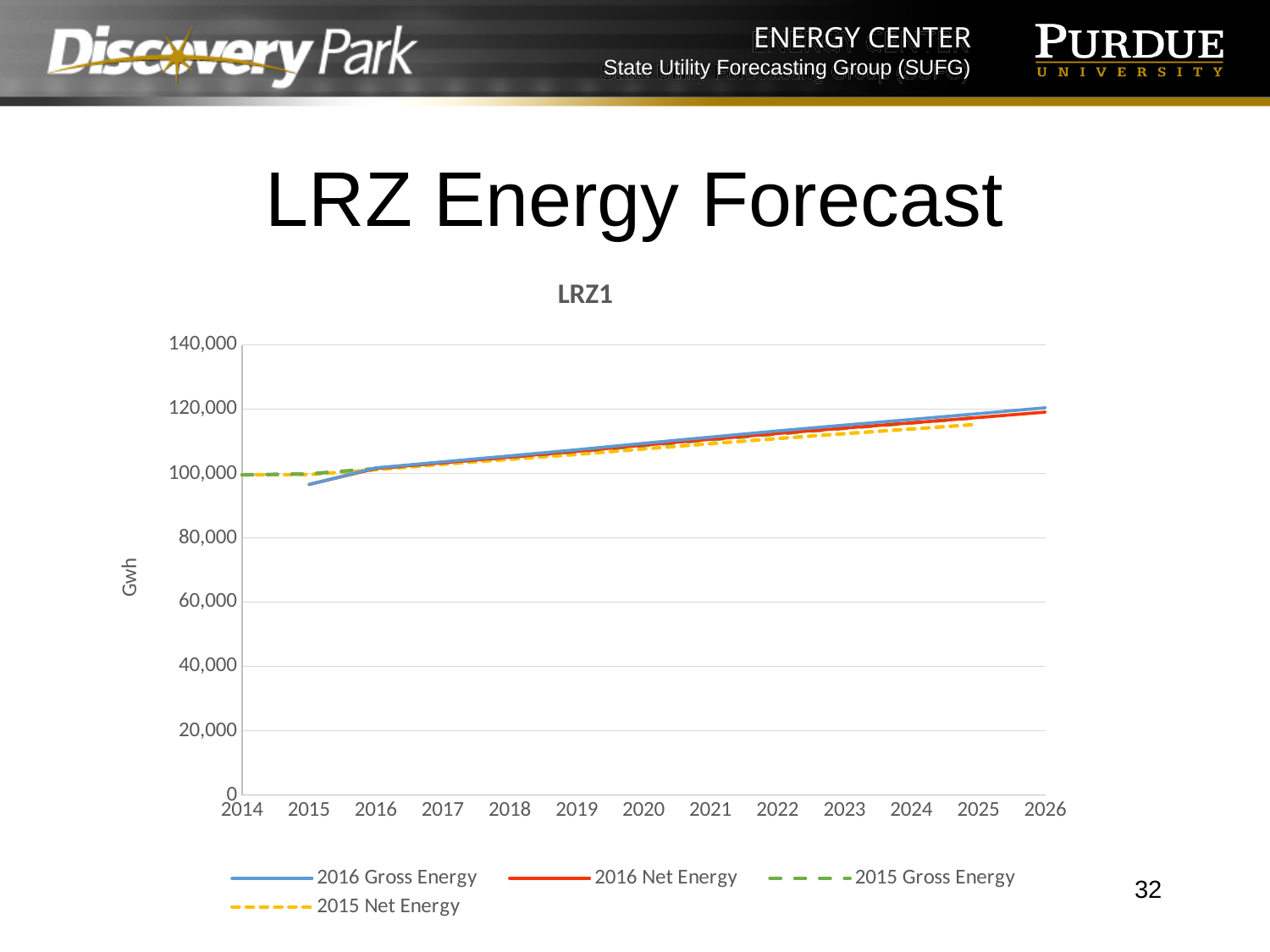
What is the title of the chart? LRZ1 Is the value for 2015 Net Energy in 2020 greater or less than 80,000? greater Is the value for 2016 Net Energy in 2026 greater or less than 140,000? less How many years are labelled on the x axis? 13 What kind of chart is shown on the slide? line chart Is the value for 2016 Net Energy in 2022 greater or less than 120,000? less What is the first year shown on the x axis? 2014 What is the label on the y axis? Gwh How many series does the legend list? 4 Does the 2016 Gross Energy line rise or fall from 2016 to 2026? rise